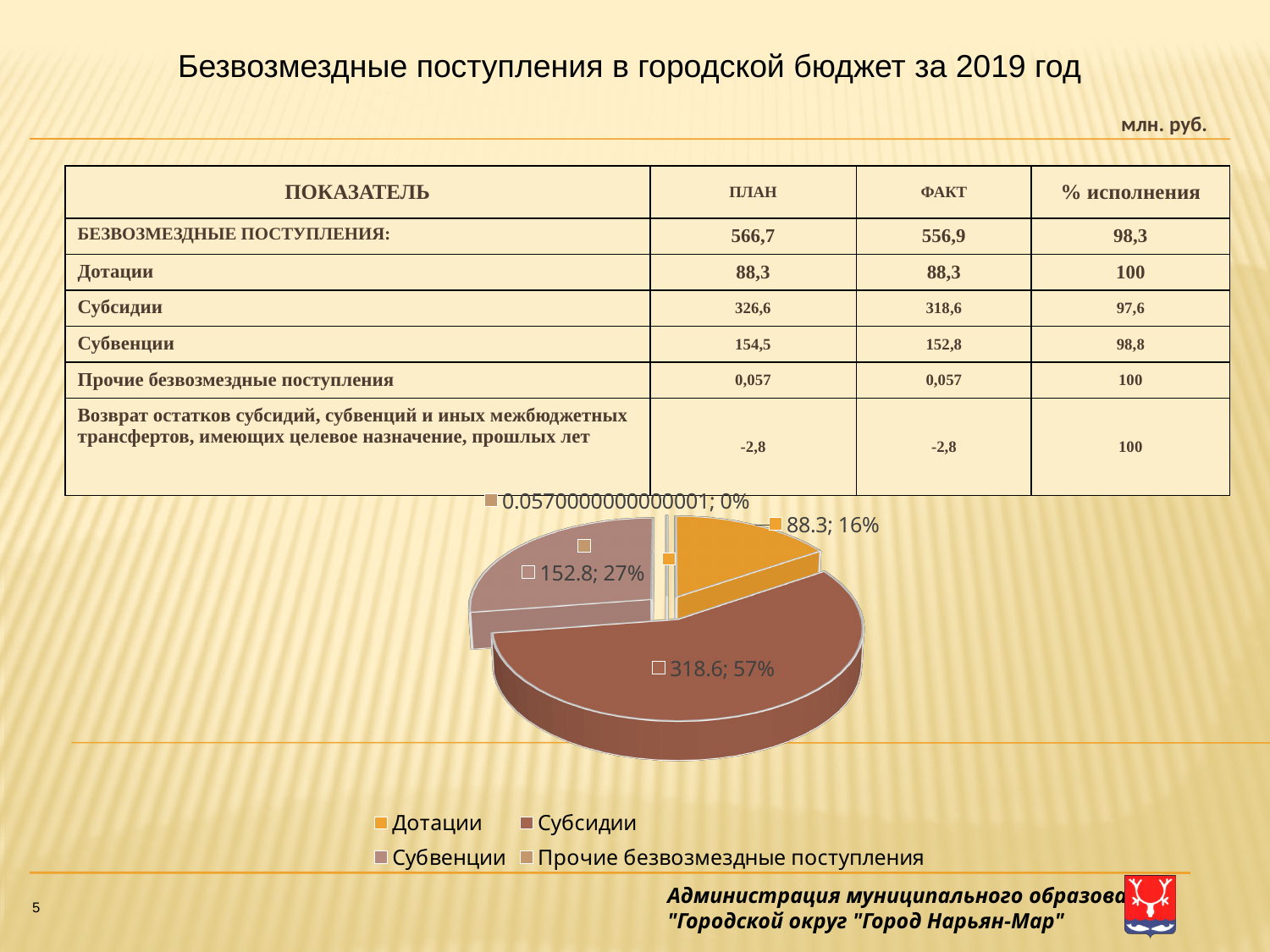
Which category has the largest slice in the pie chart? Субсидии What share of the pie does Дотации take? 16% What share of the pie does Субвенции take? 27% What kind of chart is shown on the slide? pie chart What value is shown on the pie chart for Субвенции? 152.8 What share of the pie does Субсидии take? 57% What is the difference between the values for Субсидии and Субвенции in the pie chart? 165.8 What value is shown on the pie chart for Дотации? 88.3 How many entries does the pie chart's legend list? 4 What value is shown on the pie chart for Субсидии? 318.6 Which is larger in the pie chart, Субвенции or Дотации? Субвенции Which category has the smallest slice in the pie chart? Прочие безвозмездные поступления